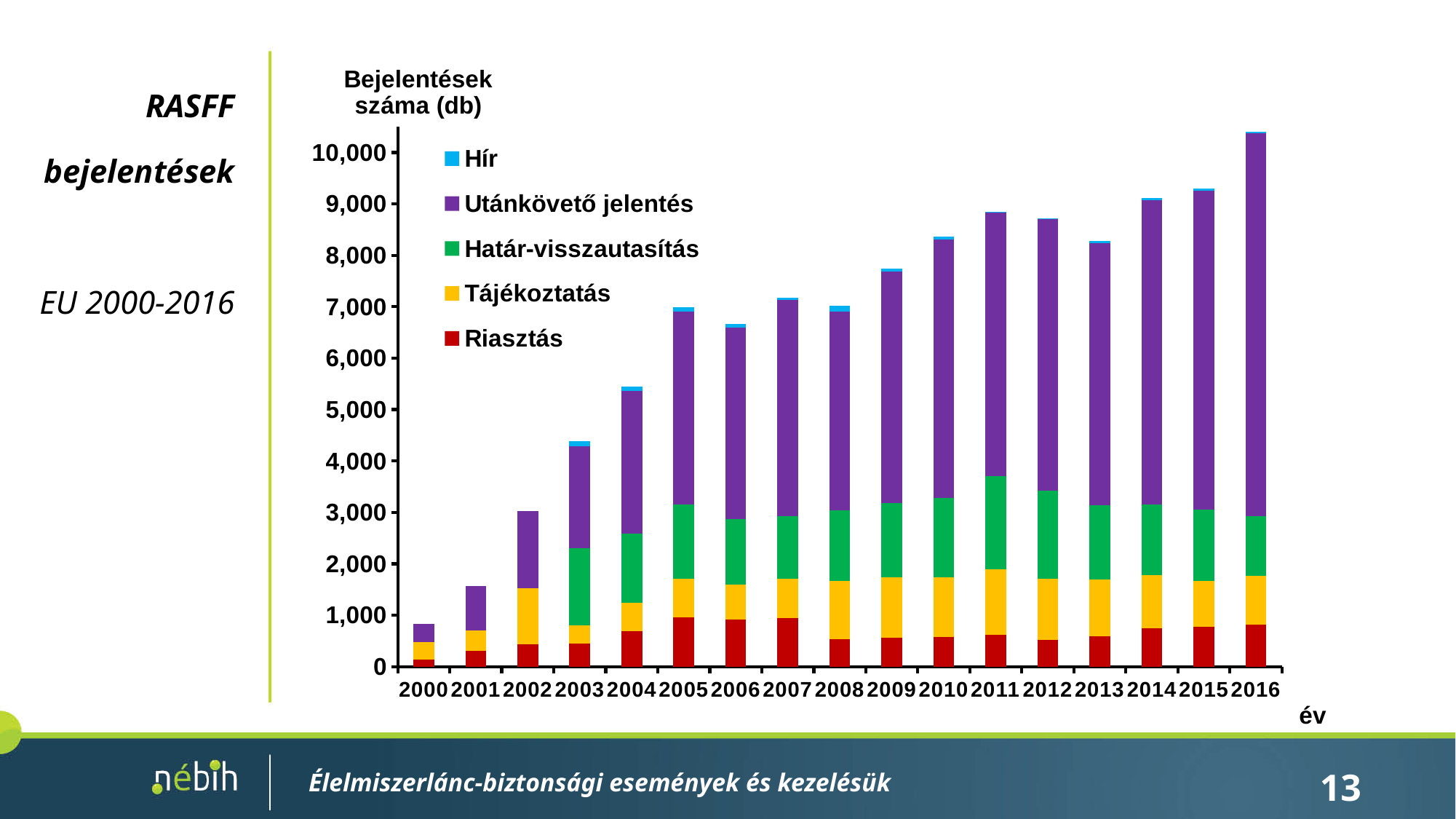
Which year has the highest total number of reports? 2016 Is the total for 2016 greater or less than 10,000? greater Which year has the lowest total number of reports? 2000 What is the title of the vertical axis? Bejelentések száma (db) Is the total for 2003 greater or less than 4,000? greater What kind of chart is shown on the slide? stacked bar chart How many years are shown on the x axis? 17 Do the total numbers of reports generally rise or fall from 2000 to 2016? rise Which series is shown in red? Riasztás Is the total for 2000 greater or less than 1,000? less How many series does the legend list? 5 Which year has a larger total, 2012 or 2013? 2012